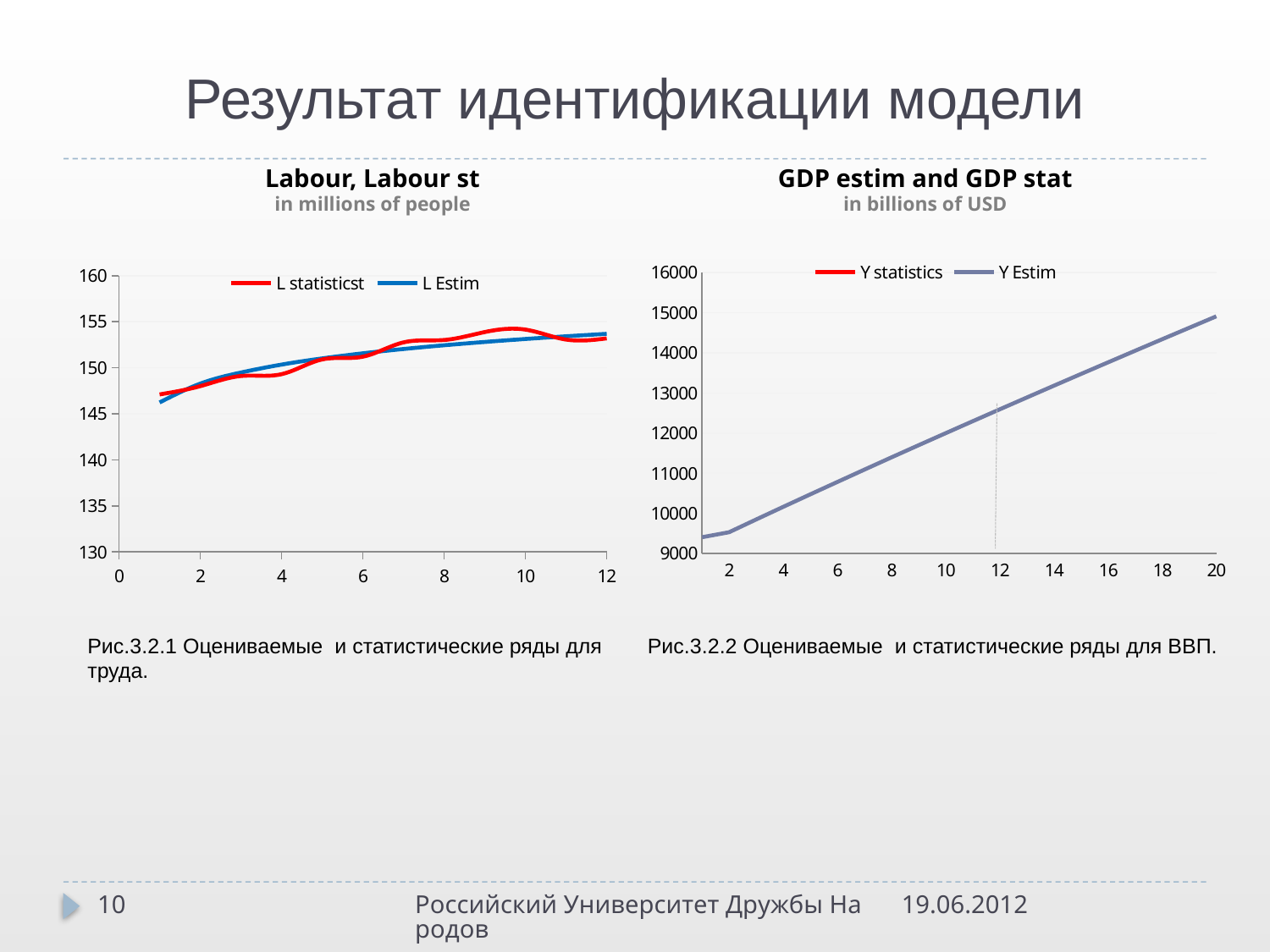
What kind of chart is the left chart titled "Labour, Labour st"? line chart In the right chart "GDP estim and GDP stat", do the values rise or fall along the x axis? rise What kind of chart is the right chart titled "GDP estim and GDP stat"? line chart In the left chart "Labour, Labour st", is the value of L Estim at x = 12 greater or less than 150? greater In the left chart "Labour, Labour st", does the L Estim series generally rise or fall along the x axis? rise What are the two legend entries of the right chart "GDP estim and GDP stat"? Y statistics and Y Estim In the right chart "GDP estim and GDP stat", is the value of Y Estim at x = 2 greater or less than 10000? less In the right chart "GDP estim and GDP stat", is the value of Y Estim at x = 20 greater or less than 14000? greater How many series does the legend of the left chart "Labour, Labour st" list? 2 How many series does the legend of the right chart "GDP estim and GDP stat" list? 2 What unit is given in the subtitle of the left chart "Labour, Labour st"? in millions of people